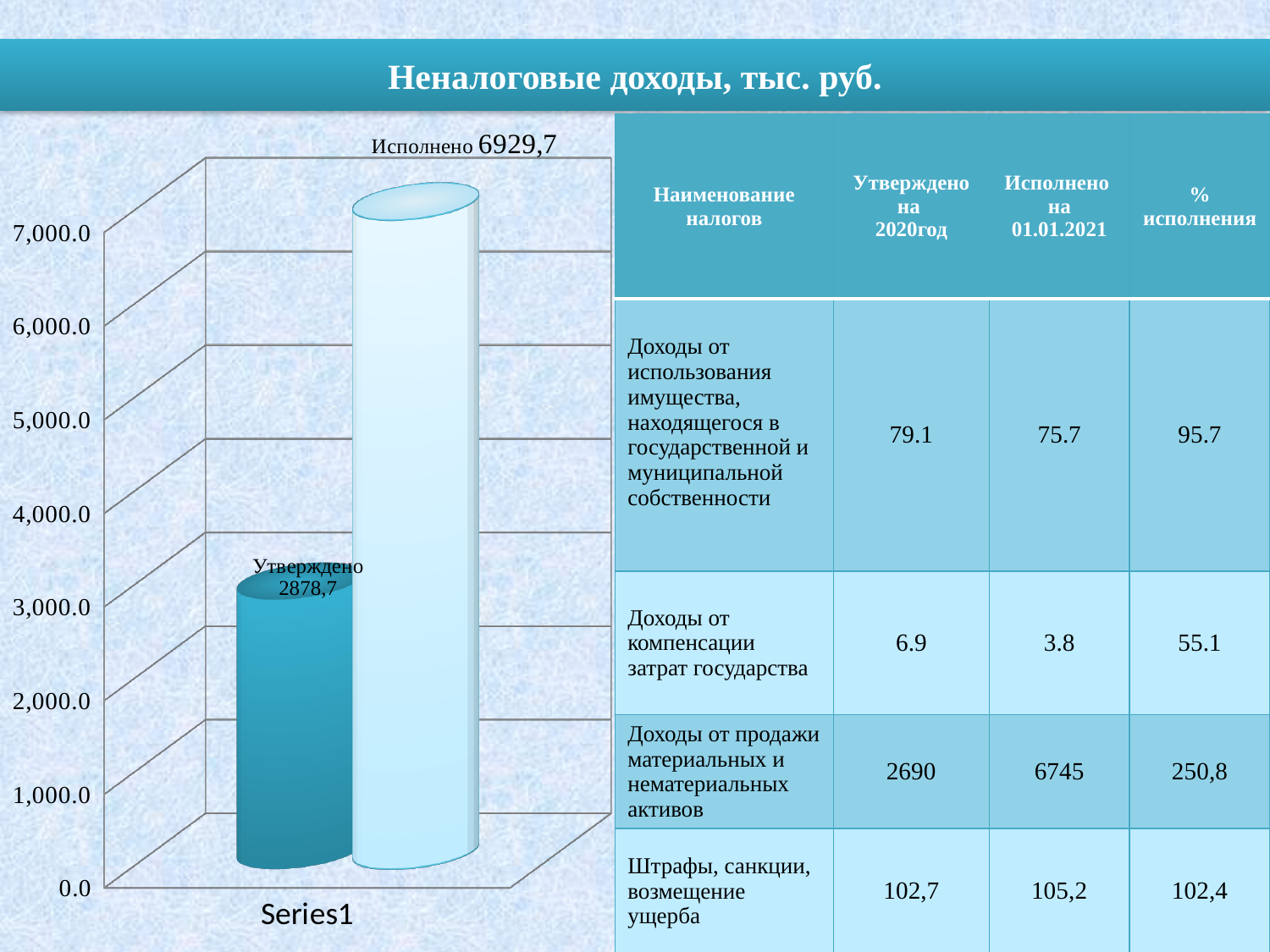
Which is larger, Утверждено or Исполнено? Исполнено Which bar is the lowest? Утверждено How many bars are plotted in the chart? 2 Is the value for Утверждено greater or less than 3,000.0? less Is the value for Исполнено greater or less than 6,000.0? greater What label appears on the horizontal axis of the chart? Series1 What is the difference between the Исполнено and Утверждено values? 4051,0 What kind of chart is shown on the slide? bar chart What is the value of the Утверждено bar? 2878,7 What is the title of the slide above the chart? Неналоговые доходы, тыс. руб. What is the value of the Исполнено bar? 6929,7 Which bar is the highest? Исполнено